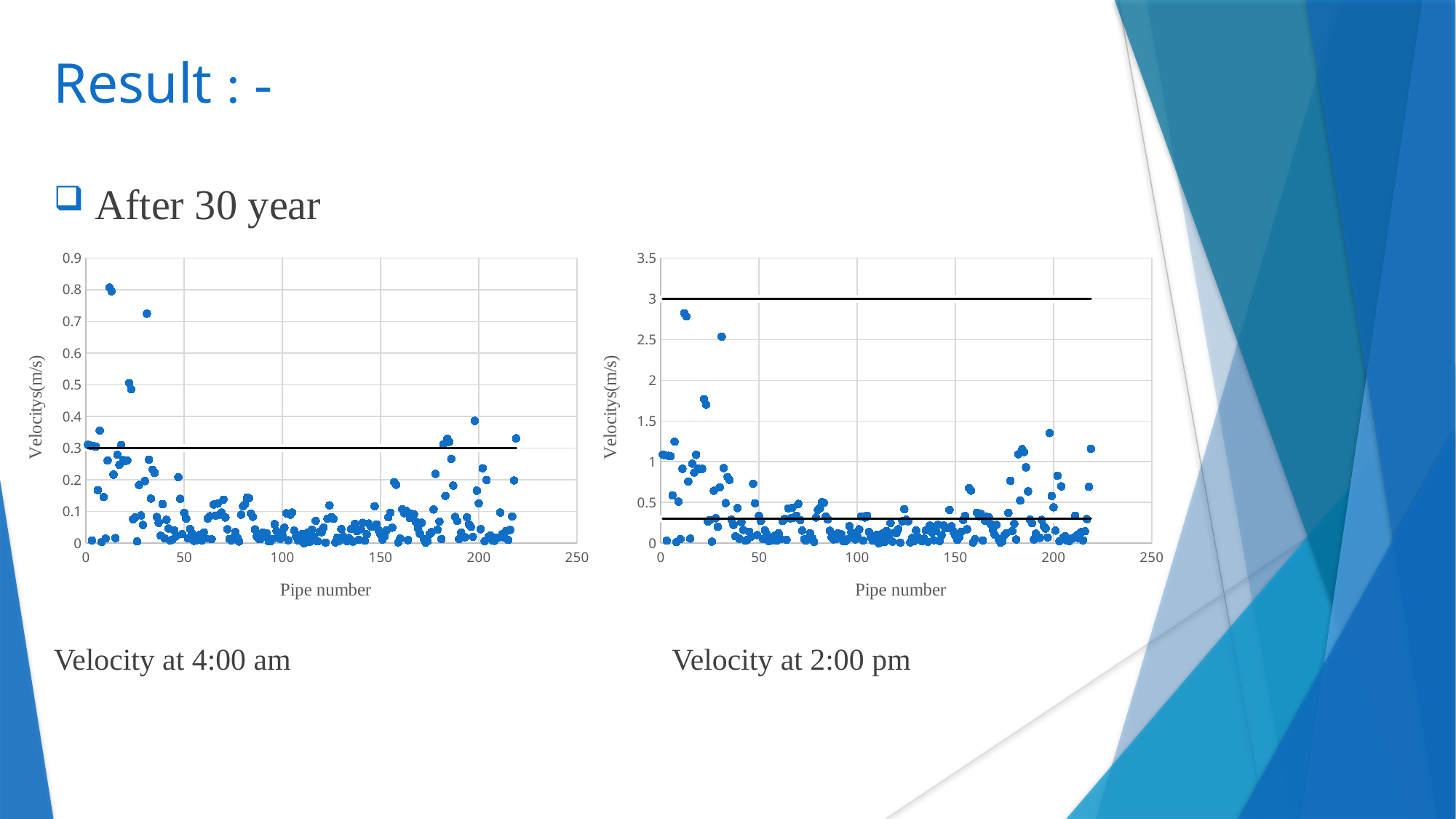
On the 'Velocity at 2:00 pm' chart, is the highest plotted velocity greater or less than 2.5? greater On the 'Velocity at 4:00 am' chart, what is the title of the x axis? Pipe number On the 'Velocity at 2:00 pm' chart, what is the maximum value shown on the y axis? 3.5 On the 'Velocity at 2:00 pm' chart, is the highest plotted velocity greater or less than 3? less On the 'Velocity at 4:00 am' chart, is the highest plotted velocity greater or less than 0.7? greater On the 'Velocity at 4:00 am' chart, what is the maximum value shown on the y axis? 0.9 What kind of chart is the 'Velocity at 4:00 am' chart on the left? Scatter chart Which chart has the higher maximum plotted velocity, 'Velocity at 4:00 am' or 'Velocity at 2:00 pm'? Velocity at 2:00 pm On the 'Velocity at 4:00 am' chart, at what velocity is the horizontal black line drawn? 0.3 What kind of chart is the 'Velocity at 2:00 pm' chart on the right? Scatter chart On the 'Velocity at 2:00 pm' chart, what is the title of the y axis? Velocitys(m/s) On the 'Velocity at 2:00 pm' chart, at what velocity is the upper horizontal black line drawn? 3